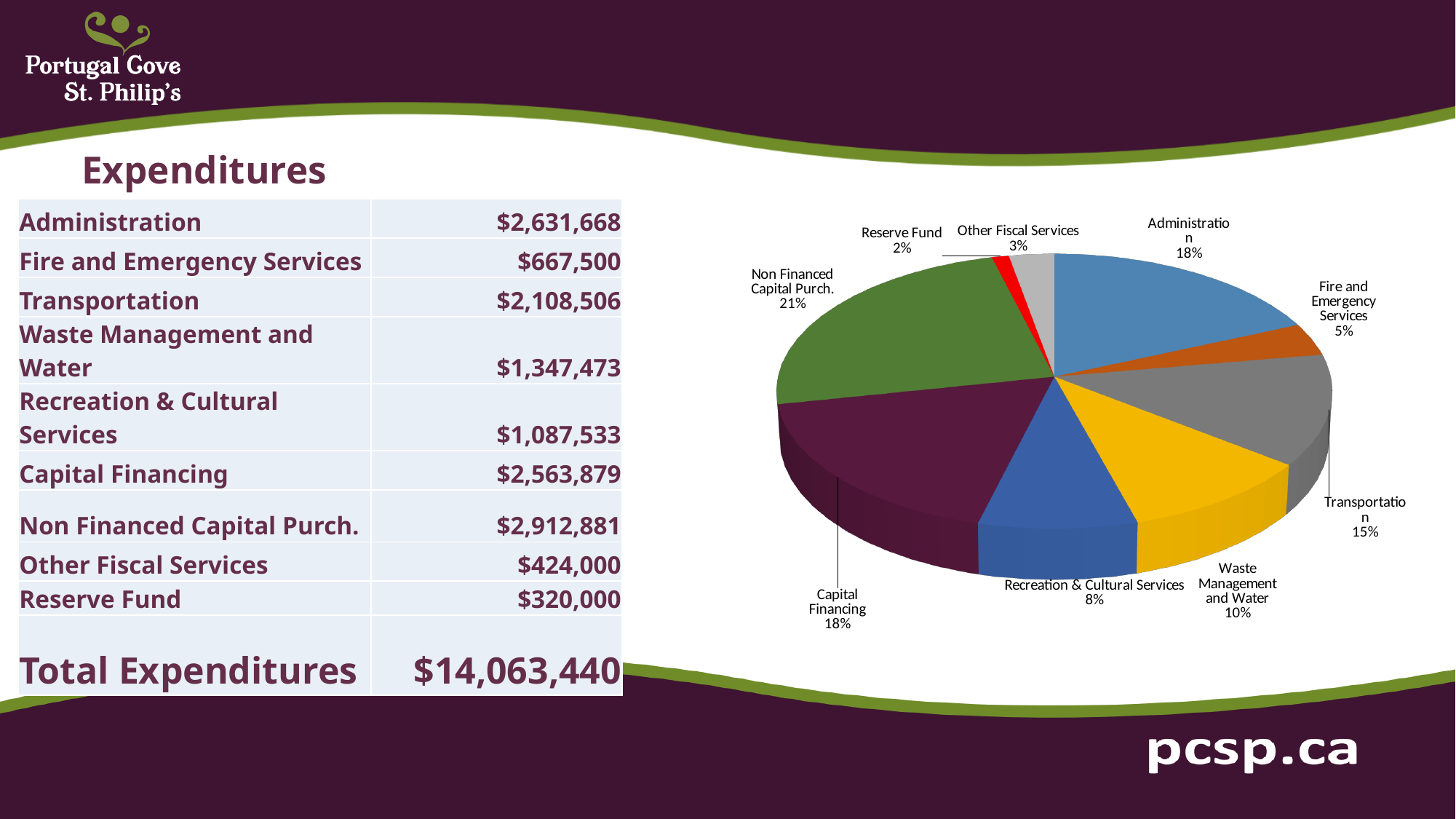
What share of the pie chart is Fire and Emergency Services? 5% Which category has the smallest slice in the pie chart? Reserve Fund How many slices does the pie chart have? 9 What is the difference in percentage points between Non Financed Capital Purch. and Capital Financing in the pie chart? 3% In the pie chart, which is larger: Transportation or Recreation & Cultural Services? Transportation What share of the pie chart is Other Fiscal Services? 3% What share of the pie chart is Waste Management and Water? 10% What kind of chart is shown on the slide? pie chart Which category has the largest slice in the pie chart? Non Financed Capital Purch. What is the title shown above the table on the slide? Expenditures